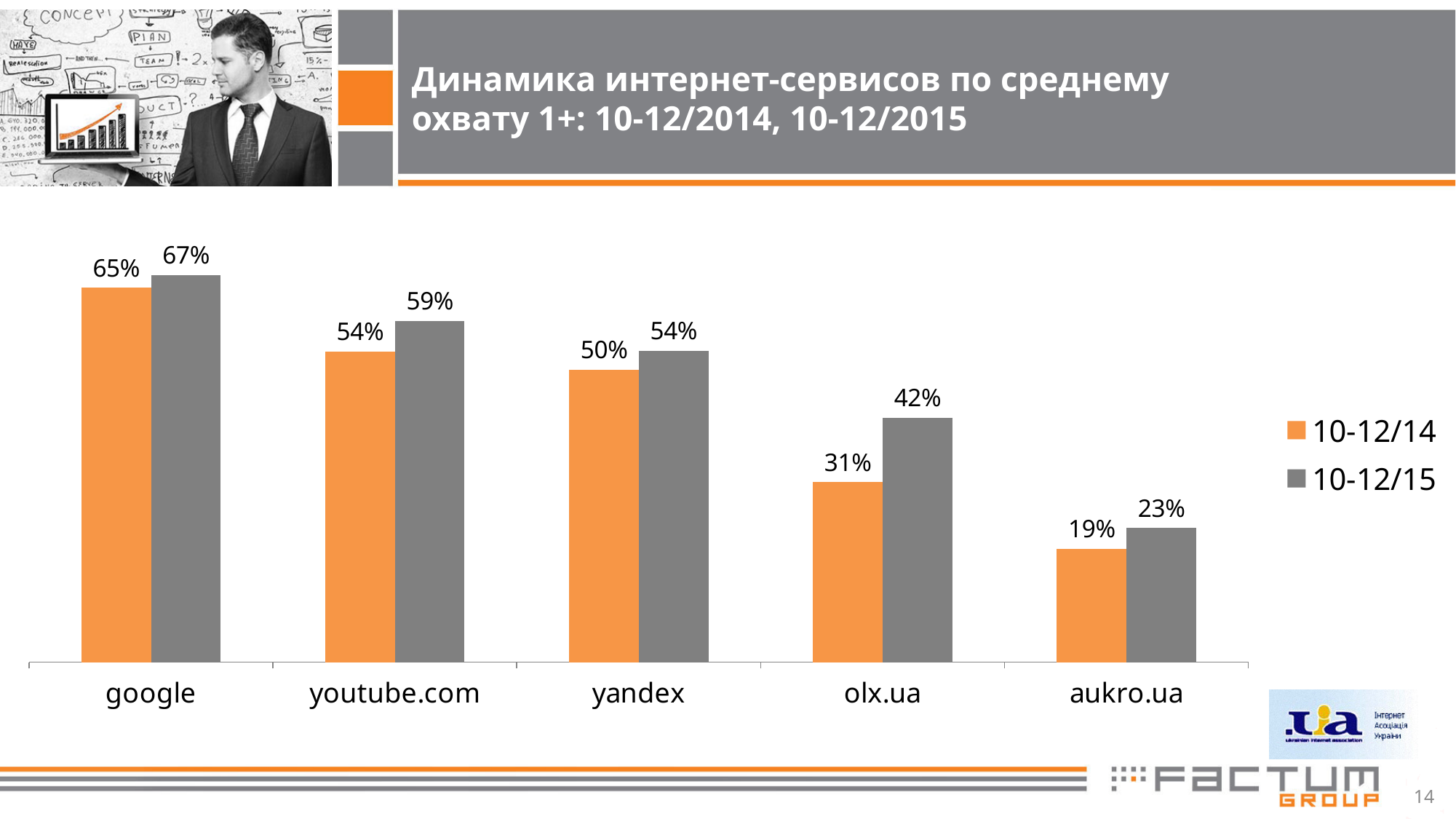
What is the value for olx.ua in the 10-12/14 series? 31% How many categories are shown on the x axis? 5 What is the difference between the 10-12/15 and 10-12/14 values for youtube.com? 5% How many series does the legend list? 2 What kind of chart is shown on the slide? bar chart Which category has the lowest value in the 10-12/15 series? aukro.ua Which category has the highest value in the 10-12/14 series? google Which is larger: the 10-12/14 value for yandex or the 10-12/15 value for olx.ua? 10-12/14 value for yandex What is the value for aukro.ua in the 10-12/15 series? 23% What is the value for google in the 10-12/15 series? 67% What is the difference between the 10-12/15 and 10-12/14 values for olx.ua? 11% Which colour represents the 10-12/14 series in the legend? orange